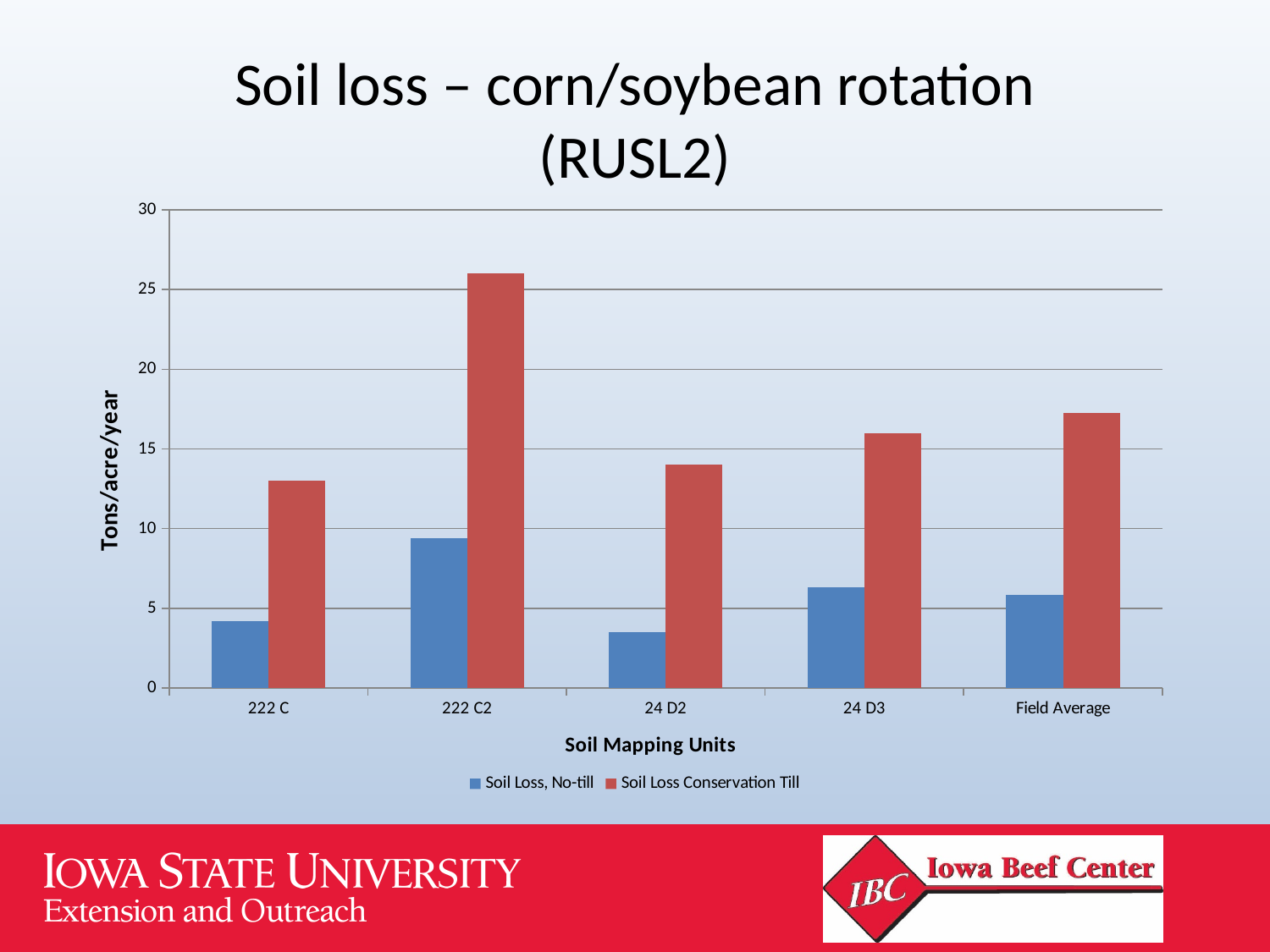
Is the Soil Loss Conservation Till value for 222 C2 greater or less than 25? greater Which category has the highest Soil Loss Conservation Till value? 222 C2 Which category has the highest Soil Loss, No-till value? 222 C2 For 24 D3, which is larger: Soil Loss, No-till or Soil Loss Conservation Till? Soil Loss Conservation Till Which category has the lowest Soil Loss, No-till value? 24 D2 What is the label of the y axis? Tons/acre/year Is the Soil Loss Conservation Till value for Field Average greater or less than 15? greater Which category has the lowest Soil Loss Conservation Till value? 222 C How many soil mapping unit categories are shown on the x axis? 5 What kind of chart is shown on the slide? bar chart How many series does the legend list? 2 Is the Soil Loss, No-till value for 222 C greater or less than 5? less